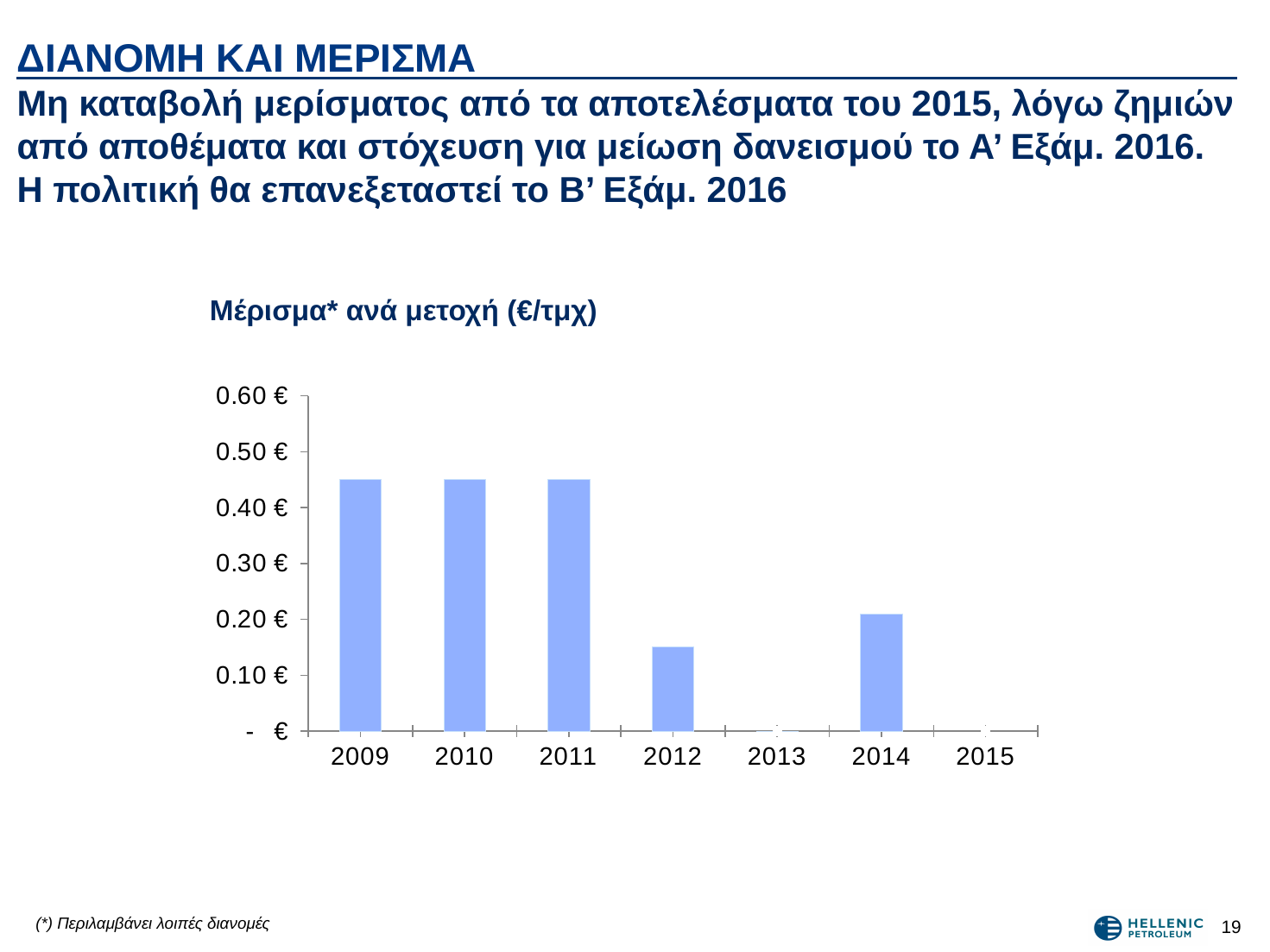
What is the highest value shown on the vertical axis of the chart? 0.60 € Is the value for 2012 greater or less than 0.20 €? less Do the dividend per share values generally rise or fall from 2009 to 2015? fall What kind of chart is shown on the slide? bar chart Is the value for 2009 greater or less than 0.40 €? greater What is the title of the chart? Μέρισμα* ανά μετοχή (€/τμχ) Is the value for 2012 greater or less than 0.10 €? greater Which year has the larger dividend per share, 2012 or 2014? 2014 Which year has the larger dividend per share, 2010 or 2012? 2010 How many years are shown on the x axis of the chart? 7